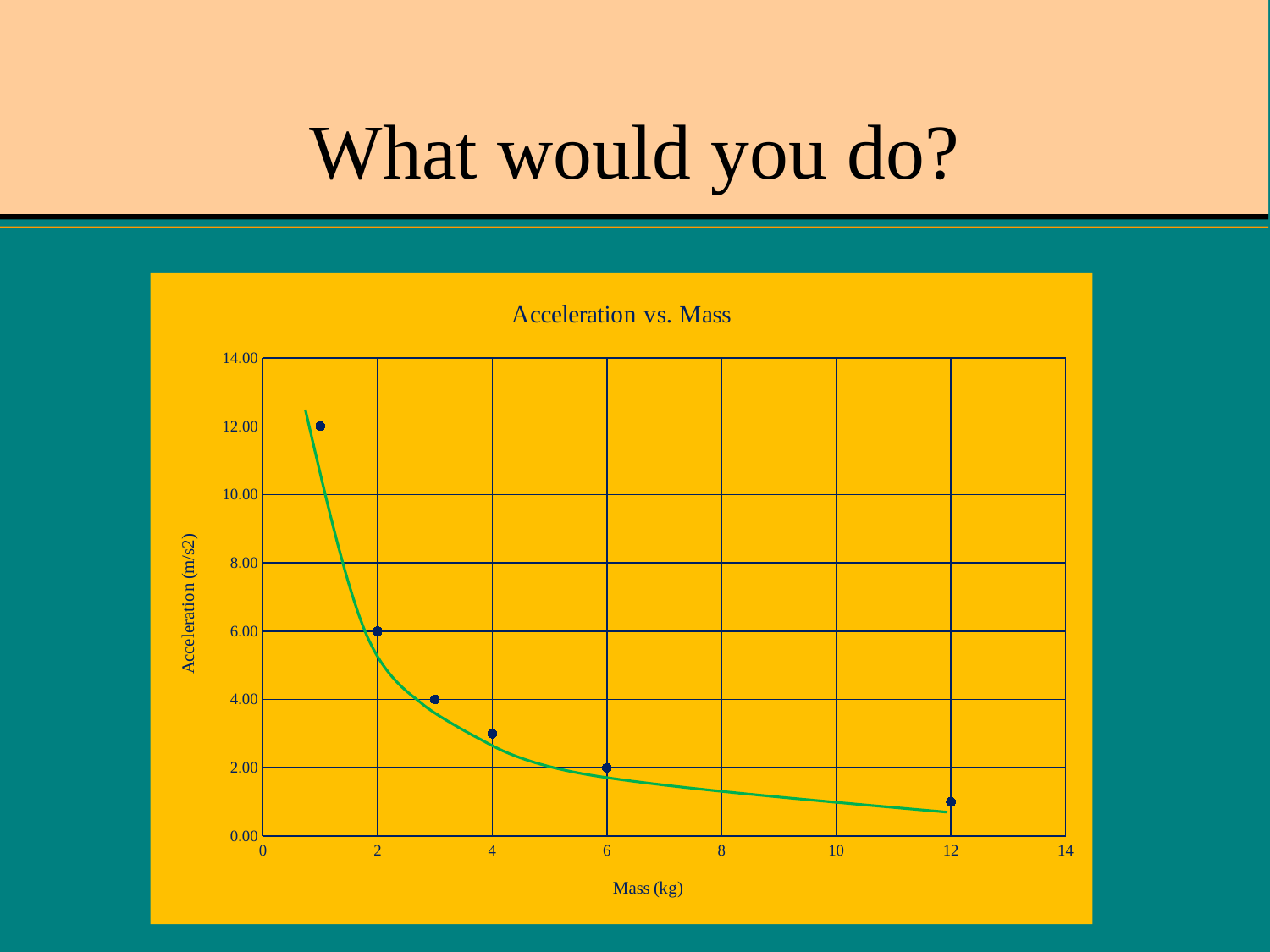
Which is larger, the acceleration at 2 kg or the acceleration at 6 kg? 2 kg What is the acceleration at a mass of 2 kg? 6.00 What is the acceleration at a mass of 6 kg? 2.00 What is the label of the x axis? Mass (kg) What is the difference between the acceleration at 2 kg and the acceleration at 6 kg? 4.00 What is the title of the chart? Acceleration vs. Mass Does acceleration rise or fall as mass increases along the x axis? fall At which mass is the acceleration lowest? 12 kg What kind of chart is shown on the slide? scatter chart Is the acceleration at a mass of 12 kg greater or less than 2.00? less How many data points are plotted on the chart? 6 Is the acceleration at a mass of 4 kg greater or less than 4.00? less